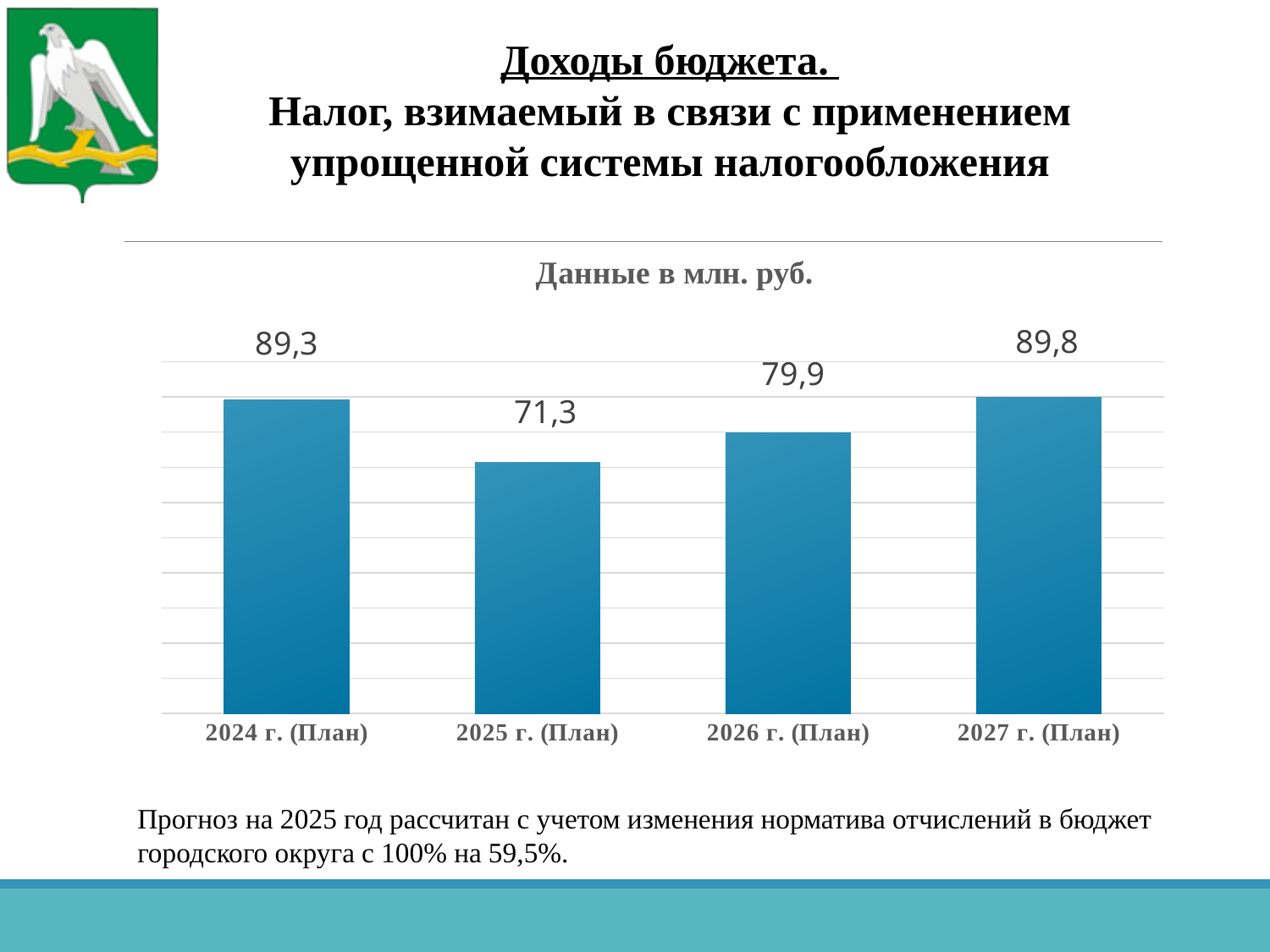
What is the difference between the values for 2027 г. (План) and 2026 г. (План)? 9,9 What is the title of the chart? Данные в млн. руб. Which year has the lowest value? 2025 г. (План) What kind of chart is shown on the slide? Bar chart Which year has the highest value? 2027 г. (План) How many bars are shown in the chart? 4 What is the difference between the values for 2024 г. (План) and 2025 г. (План)? 18 What is the value for 2027 г. (План)? 89,8 What is the value for 2026 г. (План)? 79,9 What is the value for 2024 г. (План)? 89,3 Which is larger, the value for 2026 г. (План) or 2025 г. (План)? 2026 г. (План) What is the value for 2025 г. (План)? 71,3